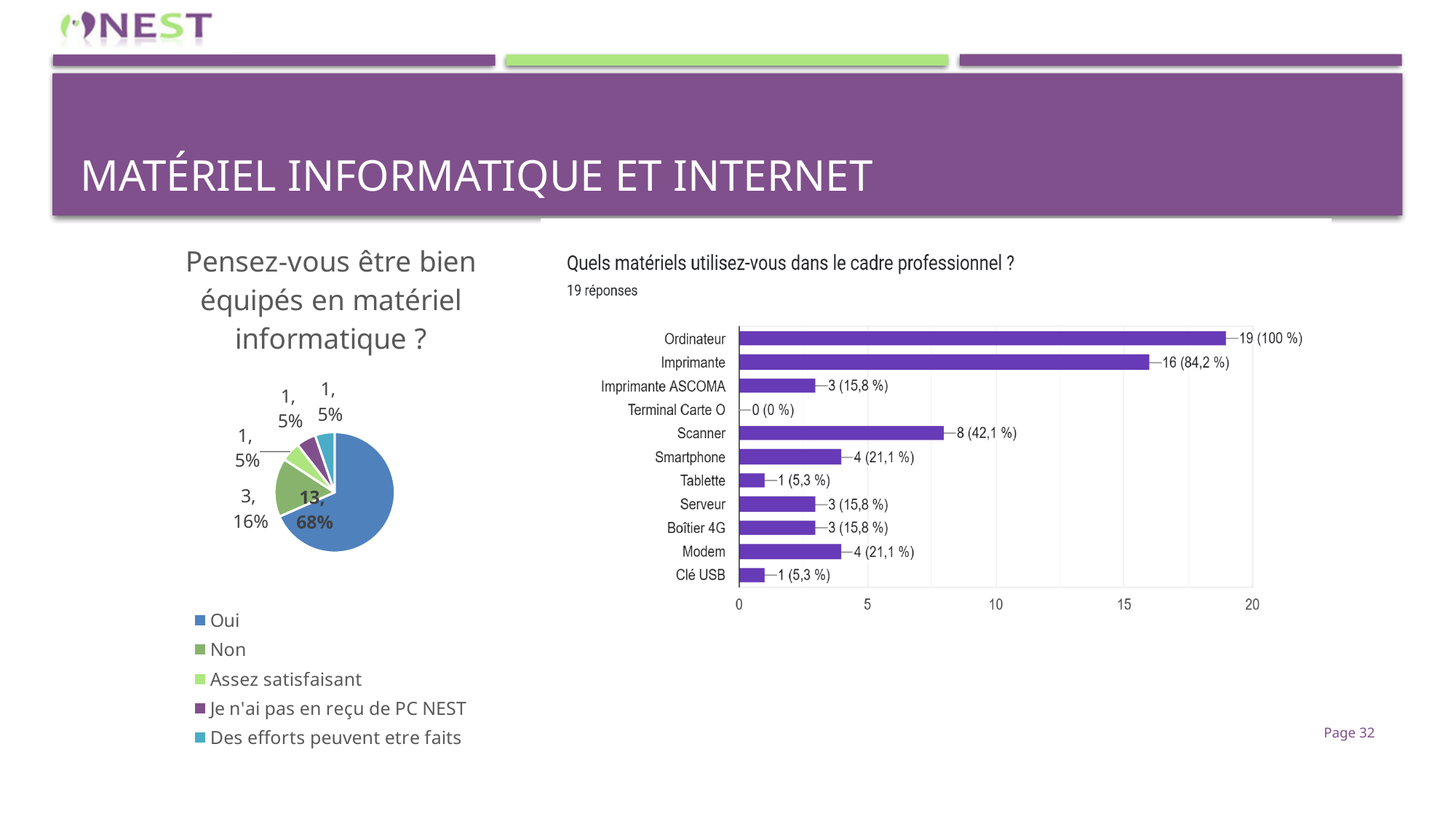
In the bar chart 'Quels matériels utilisez-vous dans le cadre professionnel ?', what is the difference in count between Ordinateur and Imprimante? 3 In the bar chart 'Quels matériels utilisez-vous dans le cadre professionnel ?', how many categories are listed? 11 In the pie chart 'Pensez-vous être bien équipés en matériel informatique ?', what share does 'Oui' have? 68% In the bar chart 'Quels matériels utilisez-vous dans le cadre professionnel ?', which has a larger value, Smartphone or Tablette? Smartphone In the bar chart 'Quels matériels utilisez-vous dans le cadre professionnel ?', what percentage is shown for Modem? 21,1 % In the bar chart 'Quels matériels utilisez-vous dans le cadre professionnel ?', which category has the highest value? Ordinateur In the bar chart 'Quels matériels utilisez-vous dans le cadre professionnel ?', which category has the lowest value? Terminal Carte O In the bar chart 'Quels matériels utilisez-vous dans le cadre professionnel ?', how many responses are shown for Scanner? 8 (42,1 %) In the pie chart 'Pensez-vous être bien équipés en matériel informatique ?', how many entries does the legend list? 5 What kind of chart is the chart titled 'Quels matériels utilisez-vous dans le cadre professionnel ?'? Bar chart In the pie chart 'Pensez-vous être bien équipés en matériel informatique ?', how many responses are 'Non'? 3 What kind of chart is the chart titled 'Pensez-vous être bien équipés en matériel informatique ?'? Pie chart